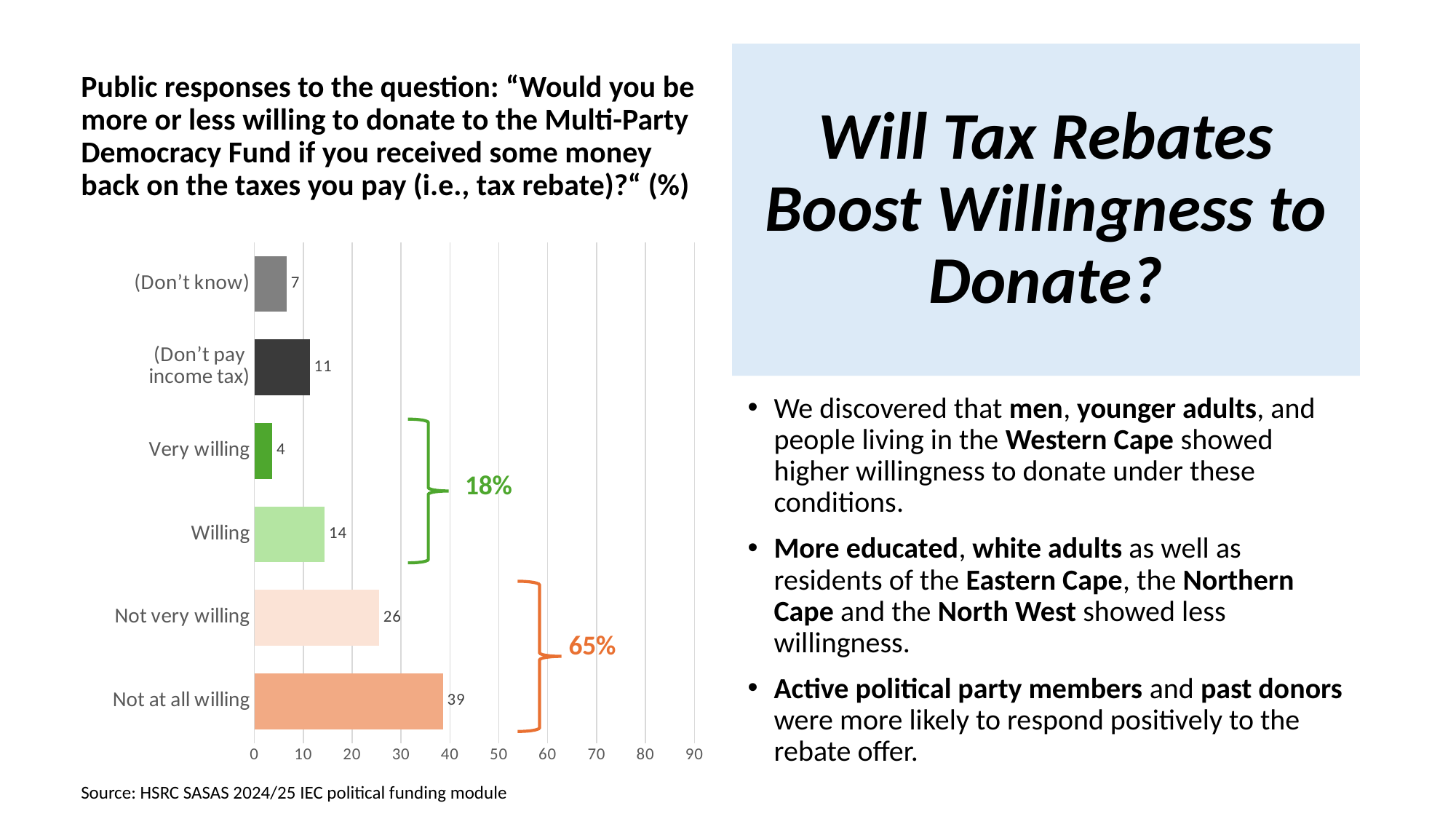
What combined percentage is shown by the orange bracket for "Not very willing" and "Not at all willing"? 65% Which category has the lowest value? Very willing What is the value for "Not at all willing"? 39 Which is larger, the value for "Willing" or the value for "(Don't pay income tax)"? Willing What is the value for "(Don't pay income tax)"? 11 What combined percentage is shown by the green bracket for "Very willing" and "Willing"? 18% How many categories are shown in the chart? 6 Which category has the highest value? Not at all willing What kind of chart is shown on the slide? Bar chart What is the difference between the values for "Not at all willing" and "Not very willing"? 13 Is the value for "Not very willing" greater or less than 20? greater What is the value for "Very willing"? 4